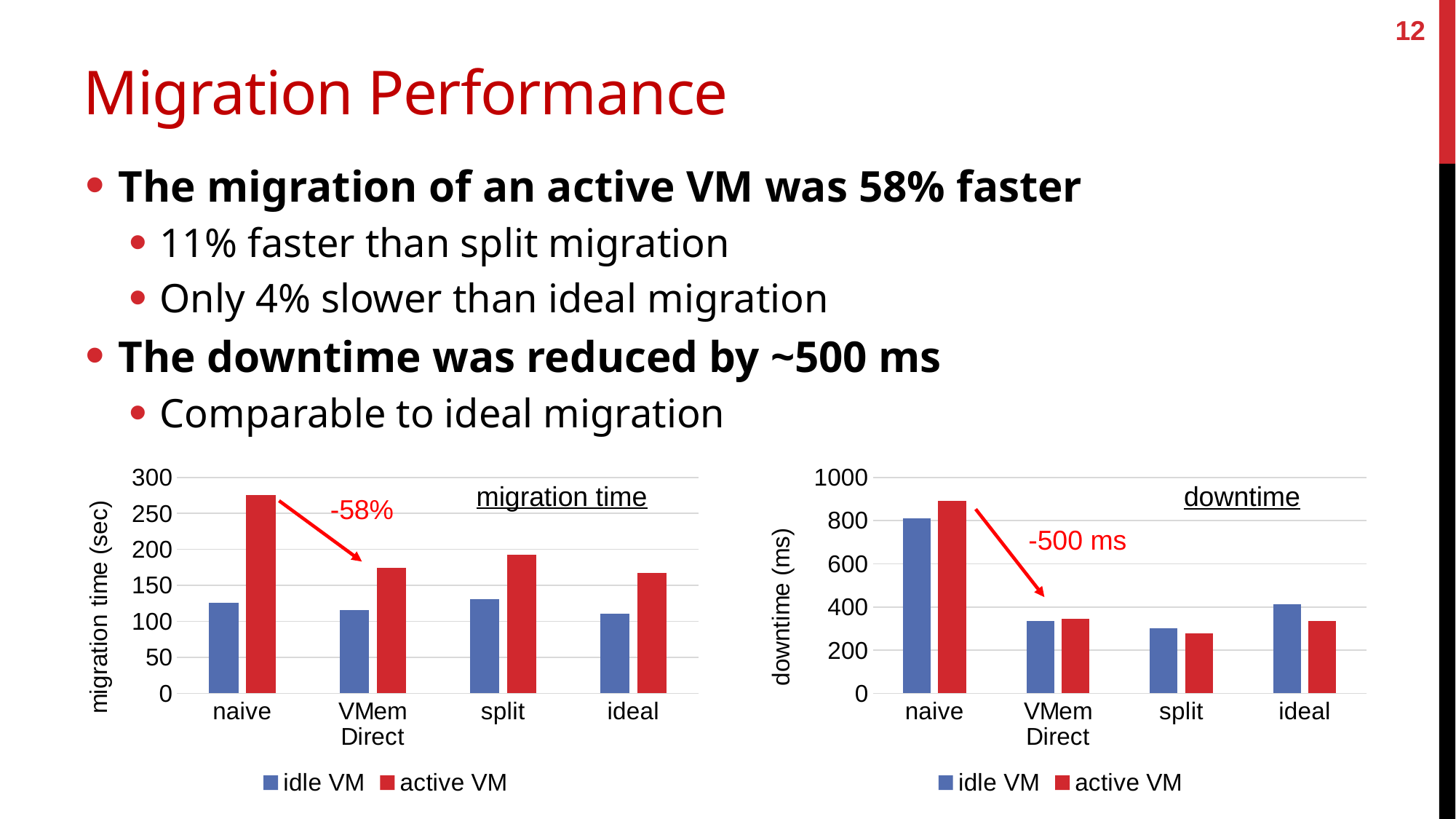
In the migration time chart, which category has the highest active VM migration time? naive In the migration time chart, which category has the lowest active VM migration time? ideal In the downtime chart, which is larger for ideal: the idle VM value or the active VM value? idle VM What is the y-axis label of the downtime chart? downtime (ms) In the migration time chart, how many categories are shown on the x axis? 4 In the downtime chart, is the active VM value for split greater or less than 400? less In the downtime chart, is the idle VM value for naive greater or less than 600? greater In the migration time chart, is the active VM value for VMem Direct greater or less than 200? less In the downtime chart, how many series does the legend list? 2 In the downtime chart, which category has the highest active VM downtime? naive In the migration time chart, what kind of chart is shown? bar chart